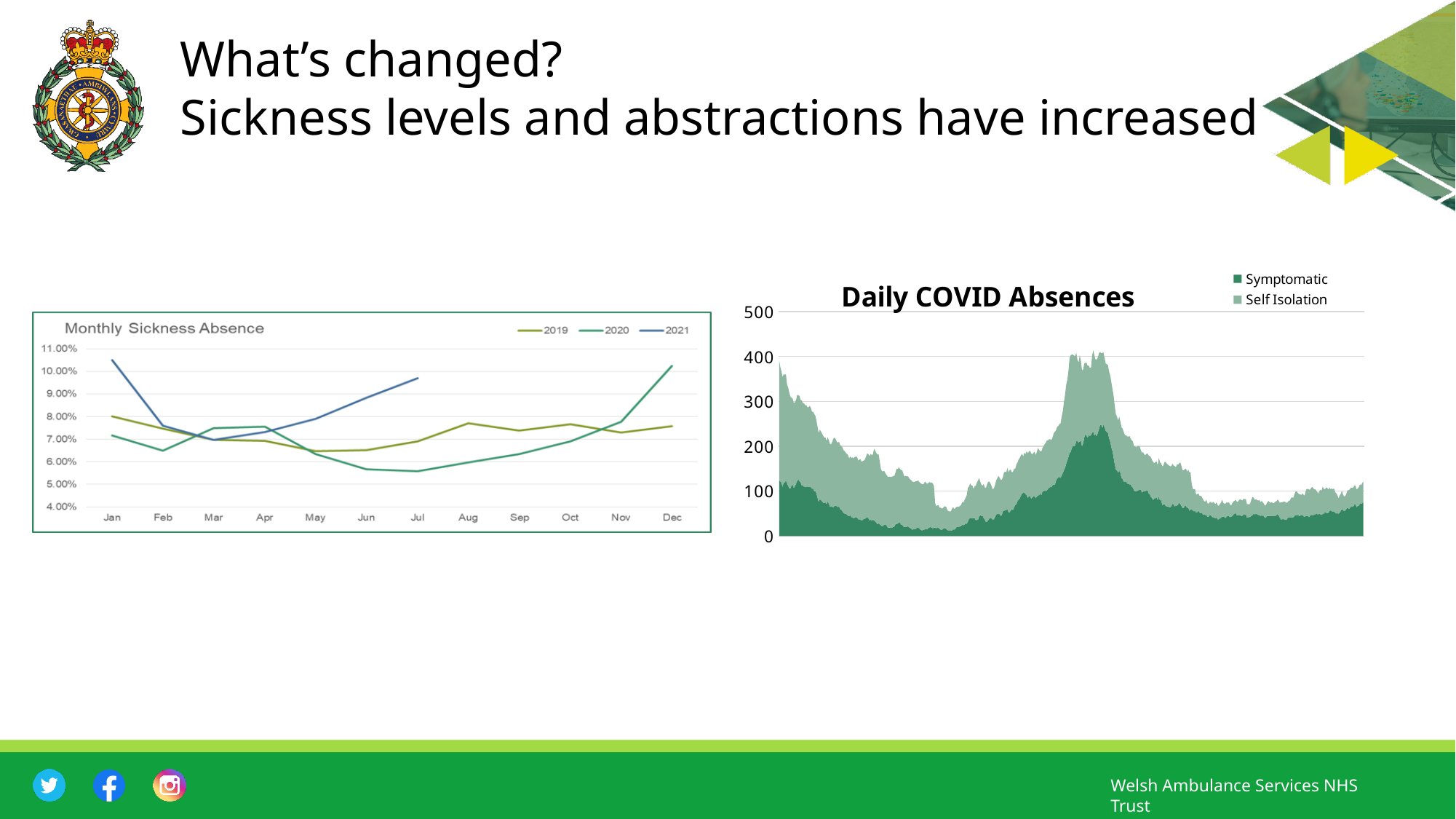
In the Monthly Sickness Absence chart, does the 2021 line rise or fall from Mar to Jul? rises In the Monthly Sickness Absence chart, which is larger for Jan: the 2019 value or the 2021 value? 2021 In the Monthly Sickness Absence chart, which month has the highest value for 2020? Dec In the Monthly Sickness Absence chart, is the 2021 value for Jan greater or less than 10.00%? greater In the Monthly Sickness Absence chart, is the 2020 value for Jul greater or less than 6.00%? less What kind of chart is the Monthly Sickness Absence chart? line chart What kind of chart is the Daily COVID Absences chart? stacked area chart Which years are listed in the legend of the Monthly Sickness Absence chart? 2019, 2020, 2021 How many series does the legend of the Daily COVID Absences chart list? 2 How many months are shown on the x axis of the Monthly Sickness Absence chart? 12 How many series does the legend of the Monthly Sickness Absence chart list? 3 In the Daily COVID Absences chart, is the highest total daily absence value greater or less than 300? greater